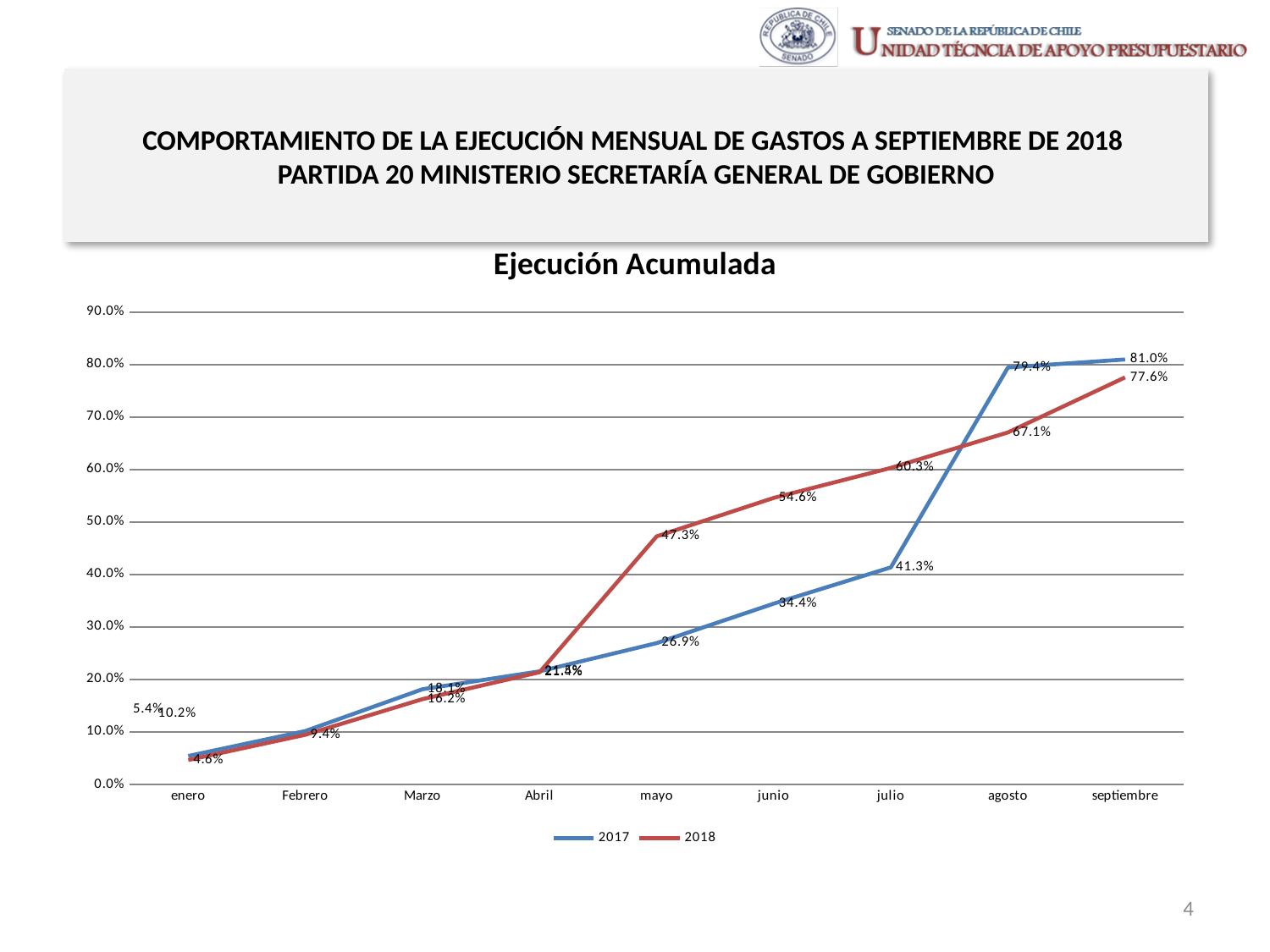
How many months are shown on the x axis? 9 What kind of chart is shown on the slide? line chart What is the value for 2017 in julio? 41.3% In which month does the 2018 series reach its highest value? septiembre How many series does the legend list? 2 What is the value for 2018 in mayo? 47.3% In julio, which series has the larger value, 2017 or 2018? 2018 What is the title of the chart? Ejecución Acumulada What is the value for 2018 in septiembre? 77.6% What is the value for 2017 in septiembre? 81.0% What is the difference between the 2017 and 2018 values in septiembre? 3.4 percentage points Do the values of the 2017 series rise or fall from enero to septiembre? rise